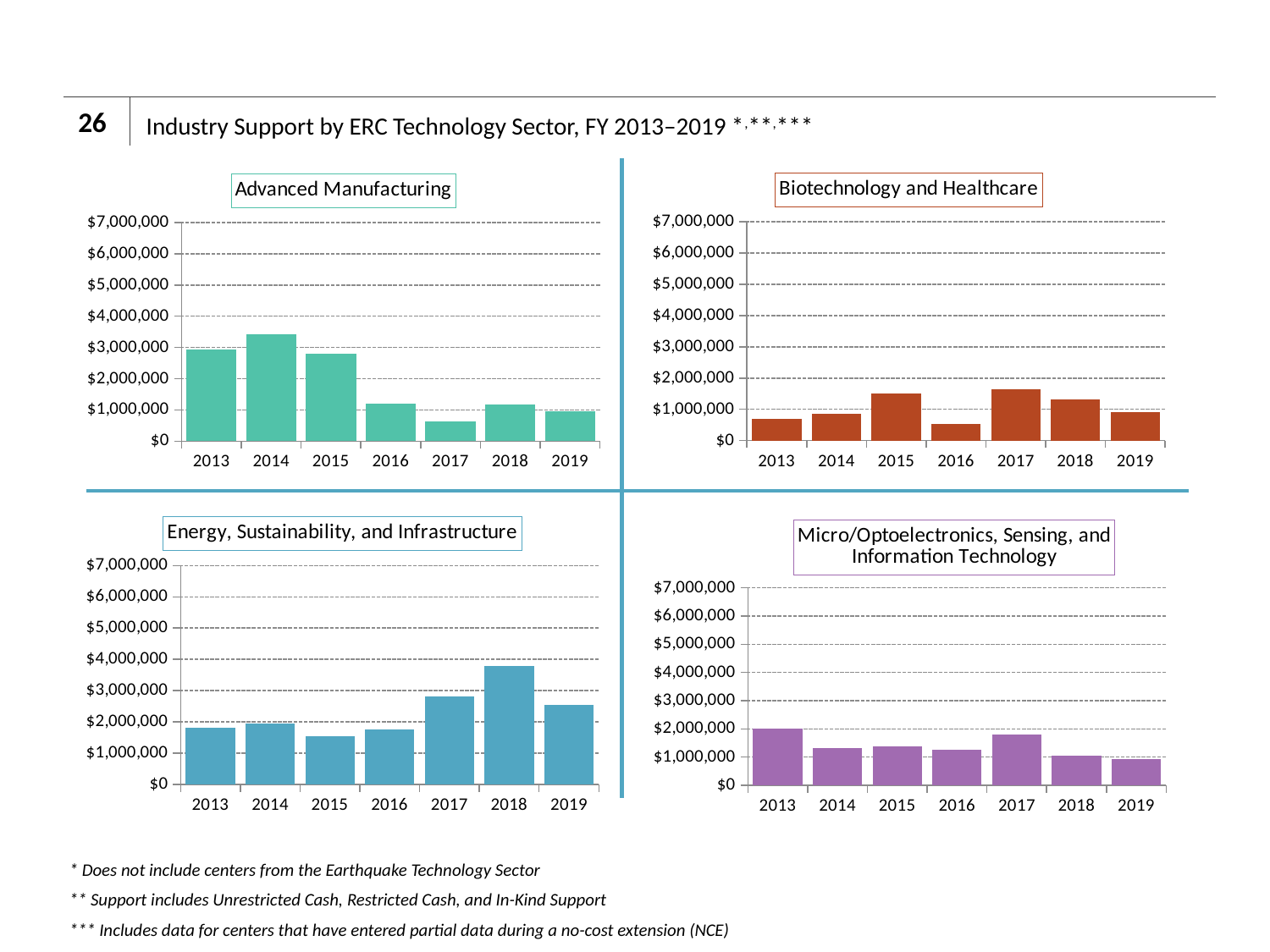
In the Micro/Optoelectronics, Sensing, and Information Technology chart, which year has the highest industry support? 2013 In the Advanced Manufacturing chart, how many fiscal years are shown on the x axis? 7 What type of chart is the Advanced Manufacturing chart? Bar chart In the Biotechnology and Healthcare chart, is the value for 2016 greater or less than $1,000,000? less In the Energy, Sustainability, and Infrastructure chart, is the value for 2018 greater or less than $3,000,000? greater In the Biotechnology and Healthcare chart, which year has the lowest industry support? 2016 In the Advanced Manufacturing chart, which year has the lowest industry support? 2017 In the Advanced Manufacturing chart, is the value for 2014 greater or less than $3,000,000? greater In the Advanced Manufacturing chart, which year has the highest industry support? 2014 In the Energy, Sustainability, and Infrastructure chart, which year has the highest industry support? 2018 How many charts are shown on the slide? 4 In the Micro/Optoelectronics, Sensing, and Information Technology chart, which year has the larger value, 2013 or 2019? 2013